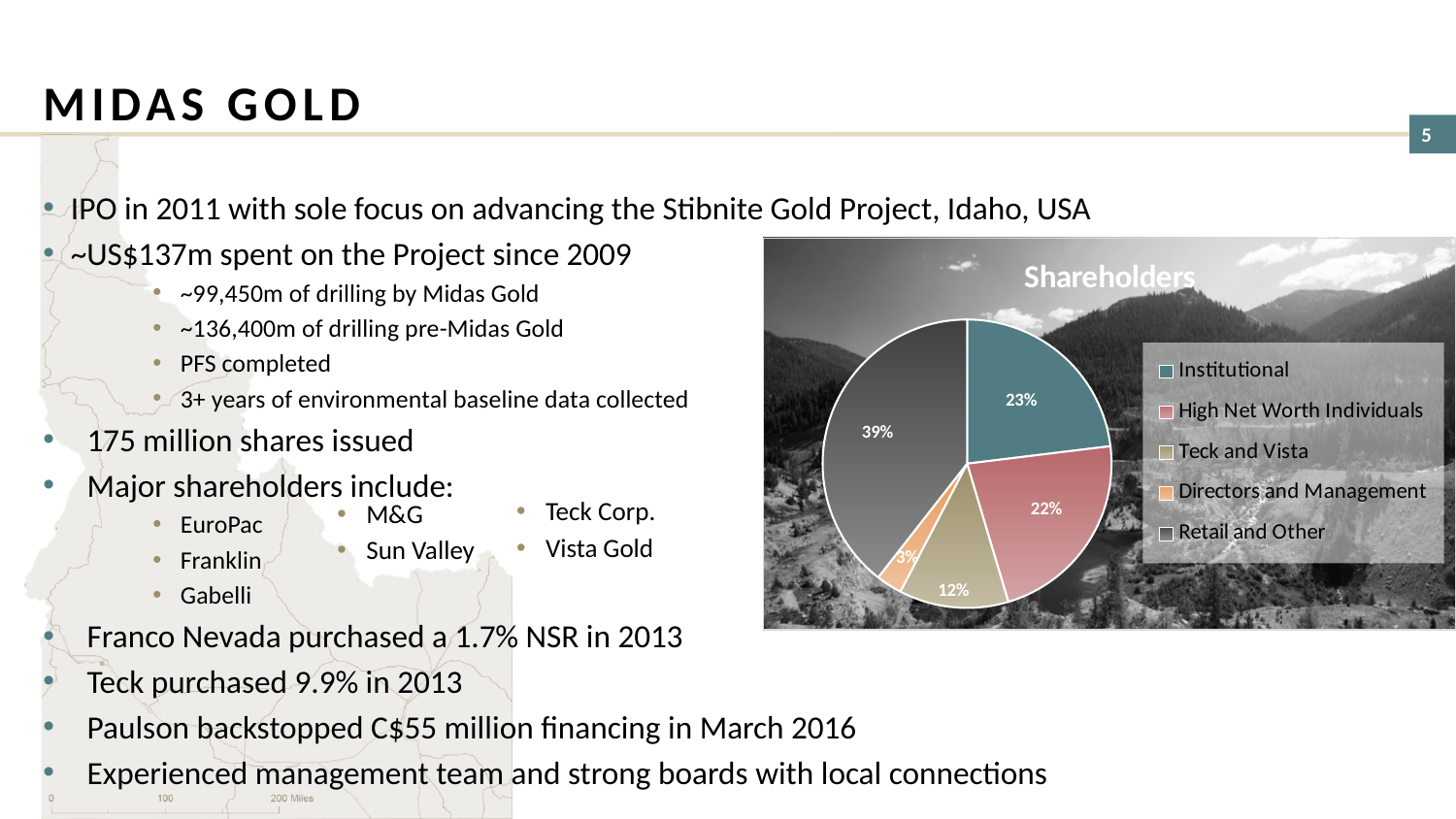
Which is larger, the Teck and Vista slice or the Directors and Management slice? Teck and Vista What is the title of the chart? Shareholders What kind of chart is shown on the slide? Pie chart What percentage is shown for Retail and Other? 39% Which shareholder category has the smallest slice of the pie? Directors and Management How many categories does the pie chart show? 5 What share of the pie is held by Institutional shareholders? 23% Which shareholder category has the largest slice of the pie? Retail and Other What is the difference in percentage points between Retail and Other and Institutional? 16 What percentage is shown for Teck and Vista? 12% What percentage is shown for High Net Worth Individuals? 22% What percentage is shown for Directors and Management? 3%